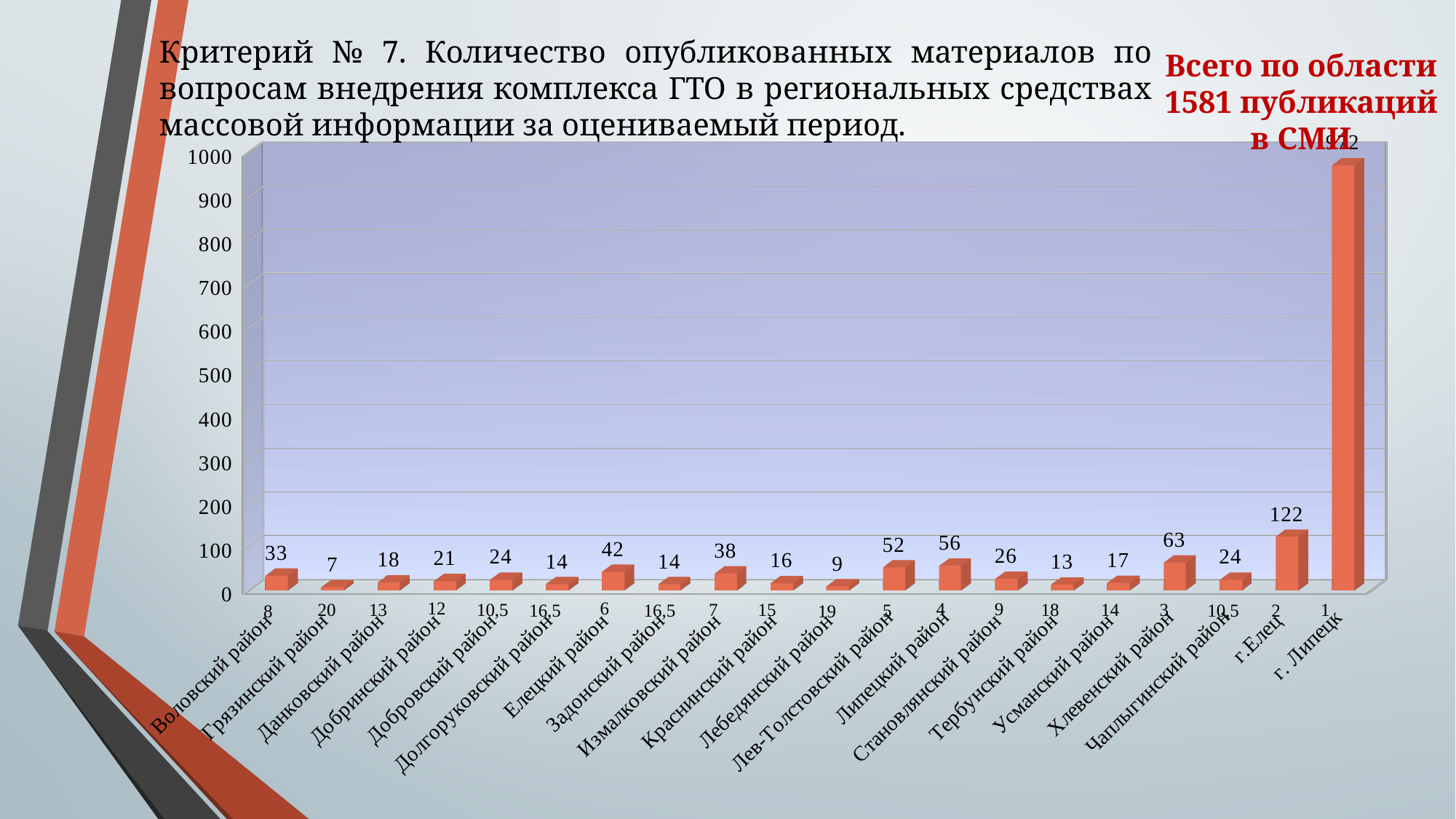
What type of chart is shown on the slide? bar chart Which category has the lowest value in the chart? Грязинский район According to the red text on the slide, what is the total number of publications in the media for the whole region? 1581 What is the value for Хлевенский район? 63 What is the value for Лебедянский район? 9 What is the value for Елецкий район? 42 Which is larger, the value for Измалковский район or the value for Воловский район? Измалковский район What is the value for г.Елец? 122 How many districts/cities are shown on the x axis of the chart? 20 Which category has the highest value in the chart? г. Липецк Is the value for г. Липецк greater or less than 900? greater What is the difference between the values for Липецкий район and Лев-Толстовский район? 4